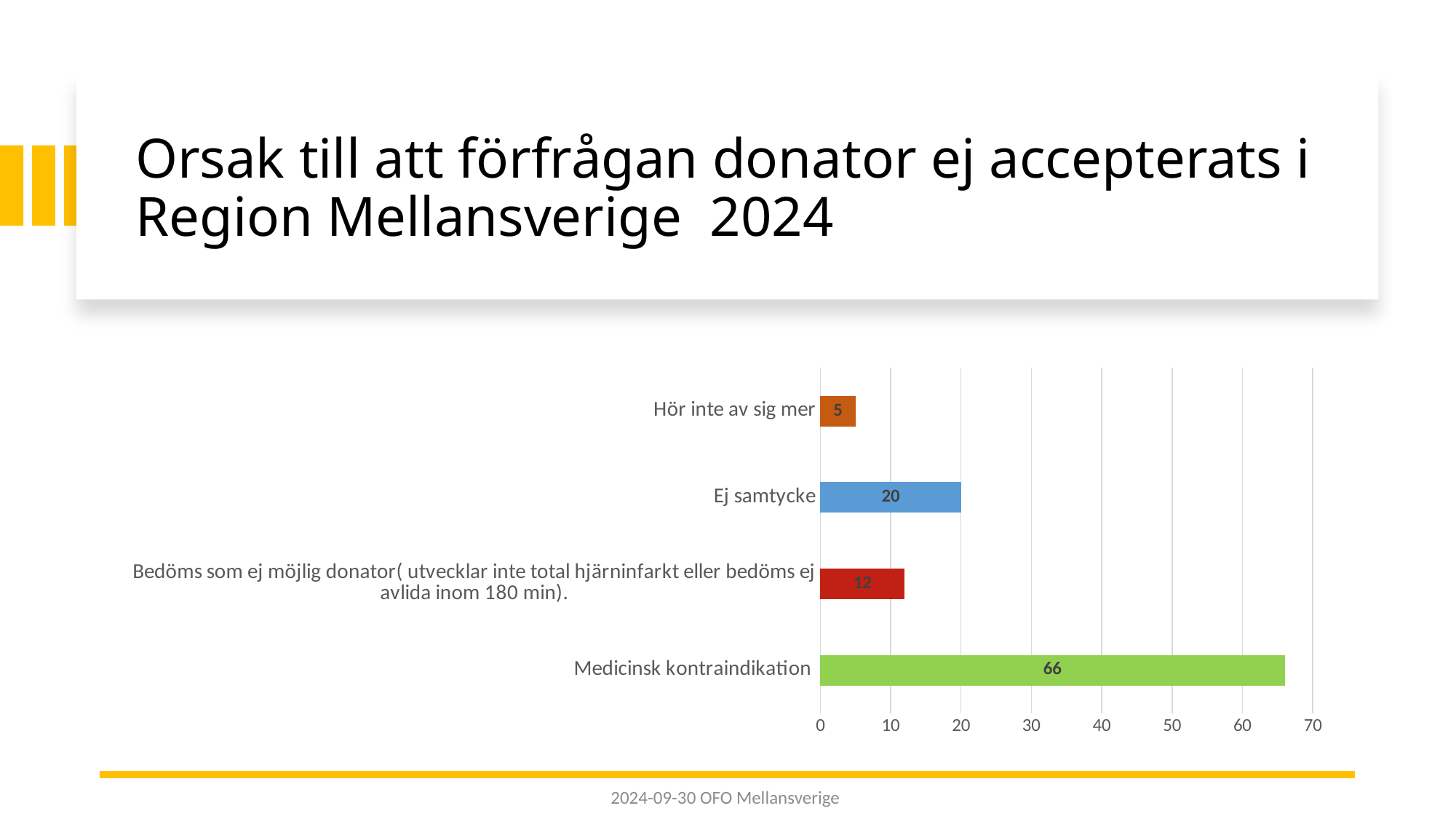
What is the difference between the values for Medicinsk kontraindikation and Ej samtycke? 46 Which category has the lowest value? Hör inte av sig mer How many categories are shown in the chart? 4 What is the value for the category 'Bedöms som ej möjlig donator'? 12 Which category has the highest value? Medicinsk kontraindikation What is the value for Medicinsk kontraindikation? 66 What is the highest value shown on the x axis? 70 What is the value for Ej samtycke? 20 What is the value for Hör inte av sig mer? 5 What kind of chart is shown on the slide? bar chart Is the value for Medicinsk kontraindikation greater or less than 60? greater Which is larger, the value for Ej samtycke or the value for Bedöms som ej möjlig donator? Ej samtycke